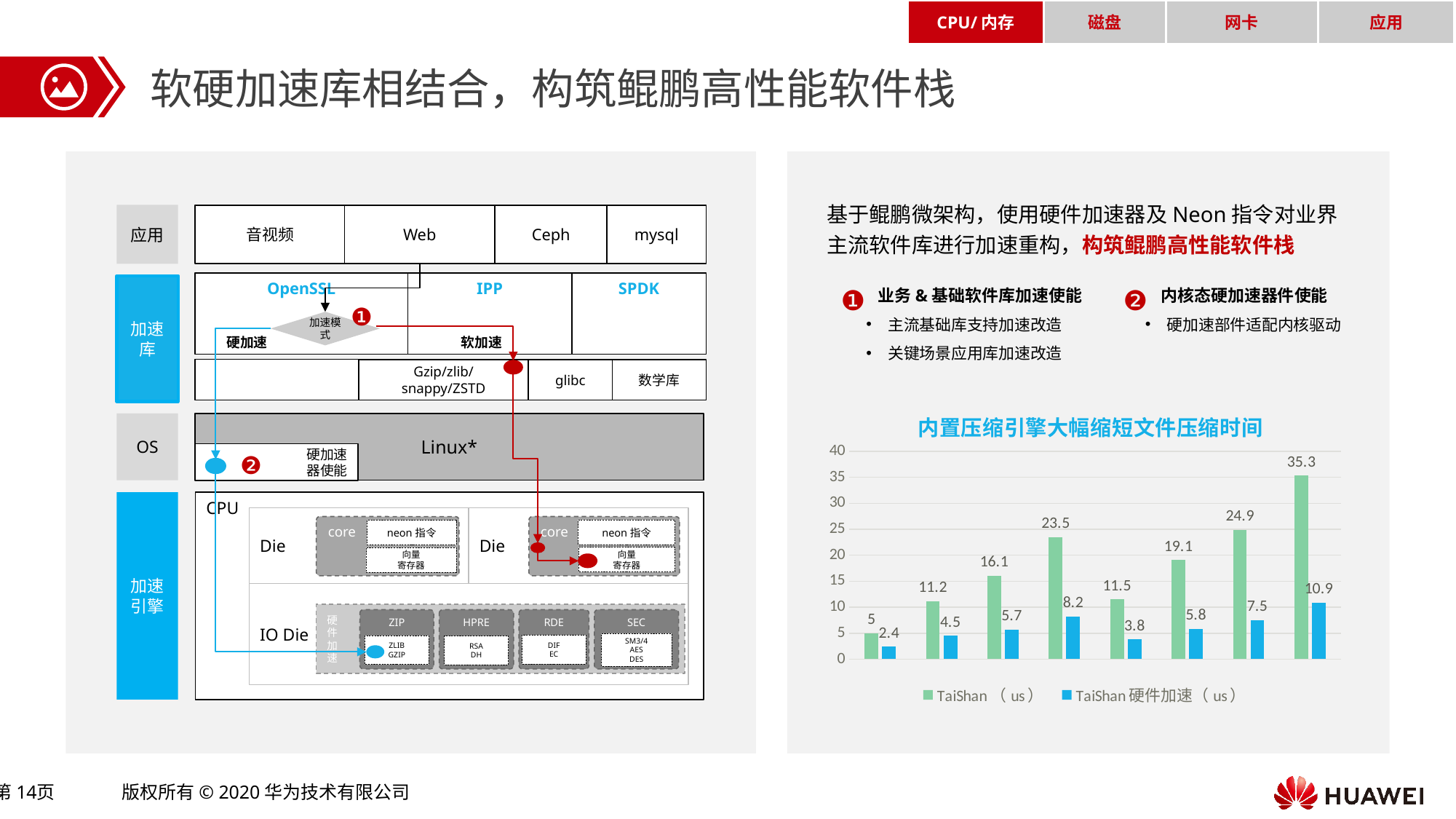
What is the lowest value of the TaiShan 硬件加速 (us) series in the chart? 2.4 In the chart, which series has the larger value in the third group of bars from the left, TaiShan (us) or TaiShan 硬件加速 (us)? TaiShan (us) In the chart, what is the TaiShan 硬件加速 (us) value for the rightmost group of bars? 10.9 What colour are the bars for the TaiShan 硬件加速 (us) series in the chart? blue What is the title of the chart on the right side of the slide? 内置压缩引擎大幅缩短文件压缩时间 What is the highest value of the TaiShan (us) series in the chart? 35.3 In the chart, is the TaiShan (us) value for the seventh group of bars from the left greater or less than 20? greater How many groups of bars are plotted in the chart? 8 In the chart, what is the difference between the TaiShan (us) and TaiShan 硬件加速 (us) values in the rightmost group of bars? 24.4 What type of chart is shown on the right side of the slide? bar chart How many series does the legend of the chart list? 2 In the chart, what is the TaiShan (us) value for the fourth group of bars from the left? 23.5